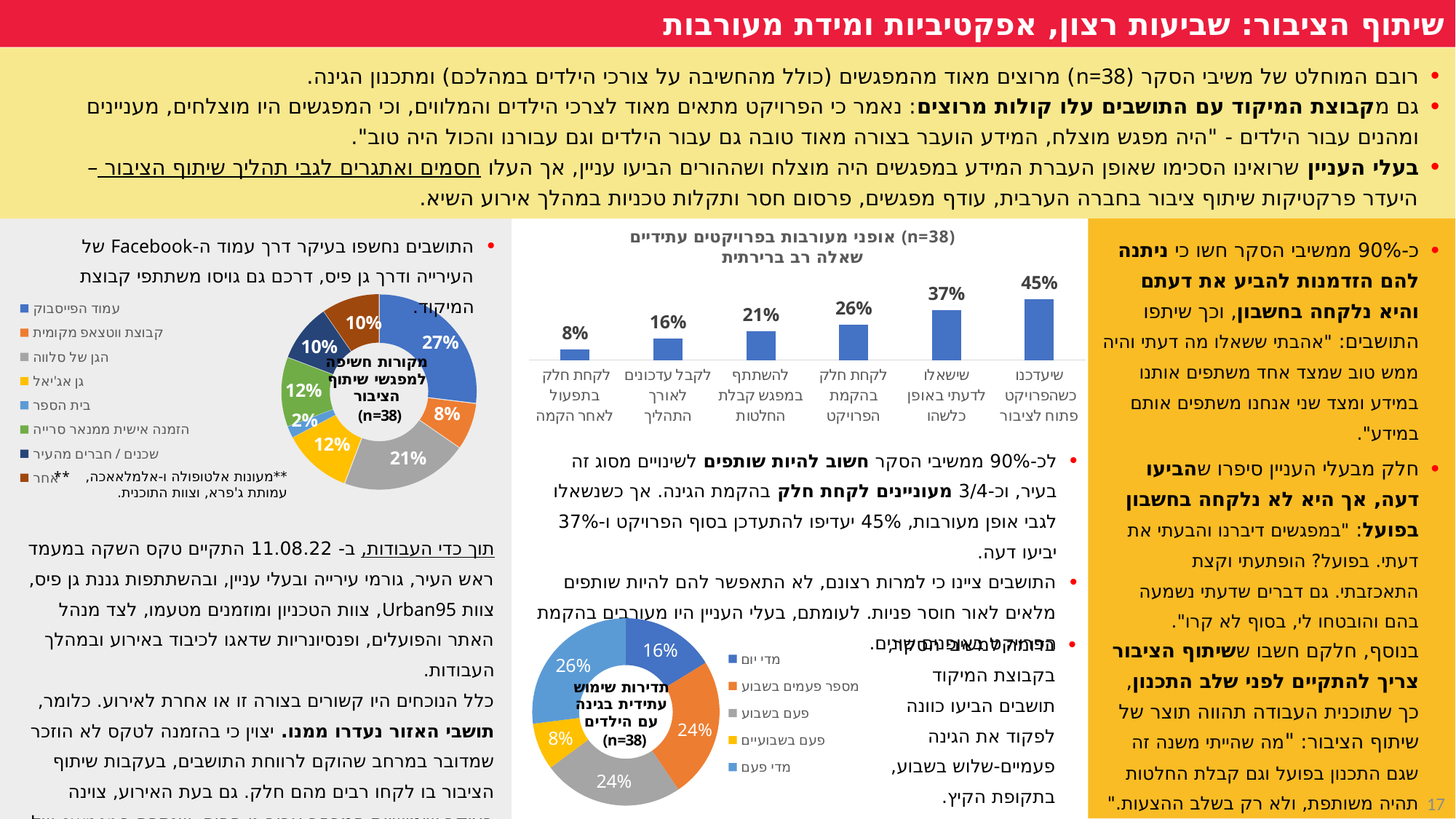
In the donut chart 'תדירות שימוש עתידית בגינה עם הילדים', what colour represents 'מדי יום'? blue In the bar chart 'אופני מעורבות בפרויקטים עתידיים', which is larger: 'לקחת חלק בהקמת הפרויקט' or 'להשתתף במפגש קבלת החלטות'? לקחת חלק בהקמת הפרויקט In the bar chart 'אופני מעורבות בפרויקטים עתידיים', what is the difference between 'שישאלו לדעתי באופן כלשהו' and 'לקבל עדכונים לאורך התהליך'? 21% In the bar chart 'אופני מעורבות בפרויקטים עתידיים', what is the value for 'שיעדכנו כשהפרויקט פתוח לציבור'? 45% In the bar chart 'אופני מעורבות בפרויקטים עתידיים', which category has the lowest value? לקחת חלק בתפעול לאחר הקמה In the donut chart 'מקורות חשיפה למפגשי שיתוף הציבור', what share does 'עמוד הפייסבוק' have? 27% What type of chart is 'אופני מעורבות בפרויקטים עתידיים'? bar chart In the donut chart 'תדירות שימוש עתידית בגינה עם הילדים', what is the value for 'מדי פעם'? 26% In the donut chart 'מקורות חשיפה למפגשי שיתוף הציבור', how many categories does the legend list? 8 In the donut chart 'מקורות חשיפה למפגשי שיתוף הציבור', which source has the smallest share? בית הספר In the bar chart 'אופני מעורבות בפרויקטים עתידיים', how many categories are shown? 6 In the donut chart 'תדירות שימוש עתידית בגינה עם הילדים', what is the difference between 'מספר פעמים בשבוע' and 'פעם בשבועיים'? 16%